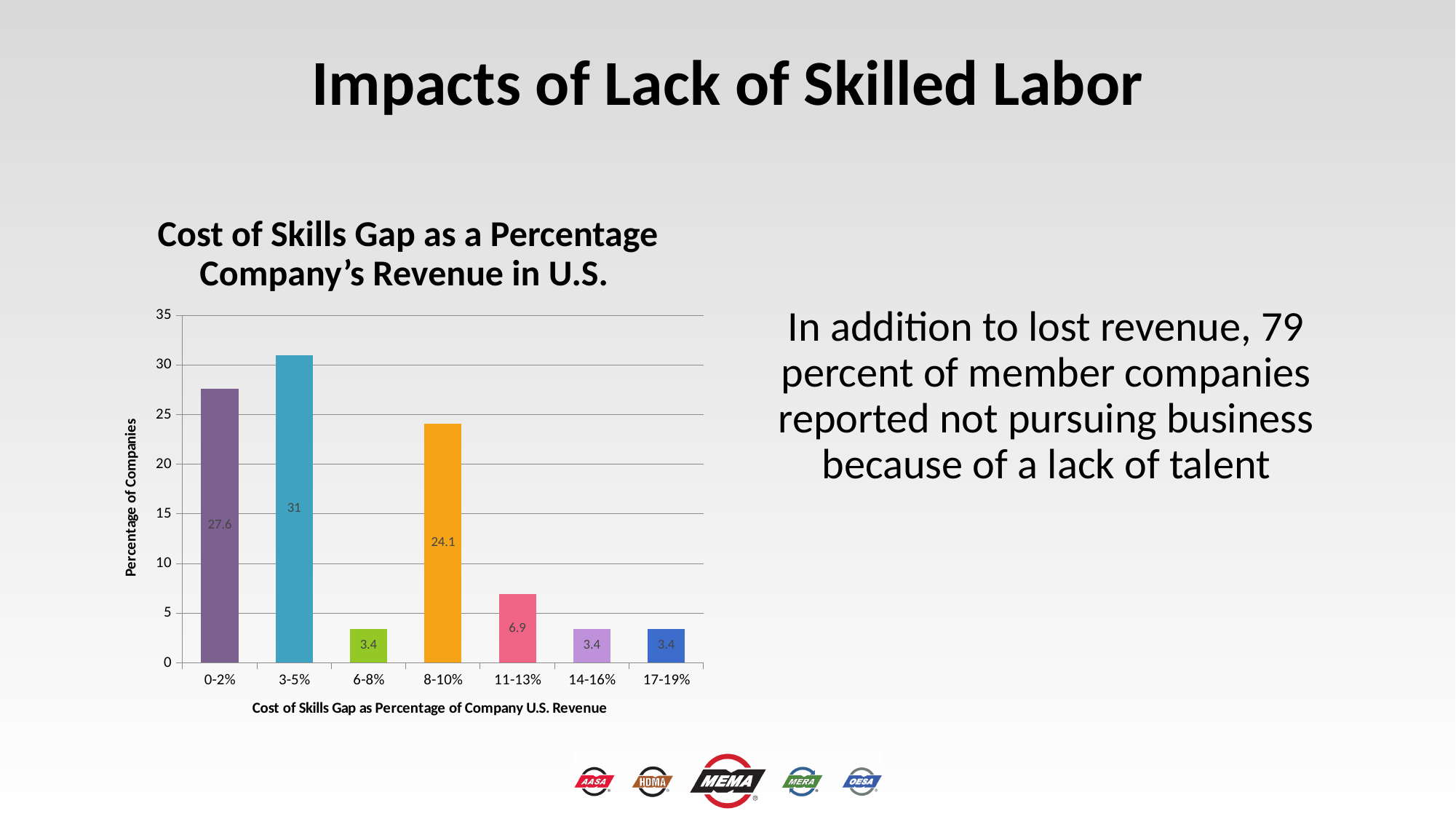
What is the difference between the values for 8-10% and 11-13%? 17.2 What is the value for the 8-10% category? 24.1 What kind of chart is shown on the slide? Bar chart What is the value for the 11-13% category? 6.9 Which cost range has the highest percentage of companies? 3-5% What percentage of companies reported a skills gap cost of 3-5% of U.S. revenue? 31 What is the value for the 0-2% category? 27.6 What is the label of the y axis of the chart? Percentage of Companies Which is larger, the value for 0-2% or the value for 8-10%? 0-2% How many cost range categories are shown on the x axis? 7 What is the difference between the values for 3-5% and 0-2%? 3.4 Is the value for 3-5% greater or less than 30? greater